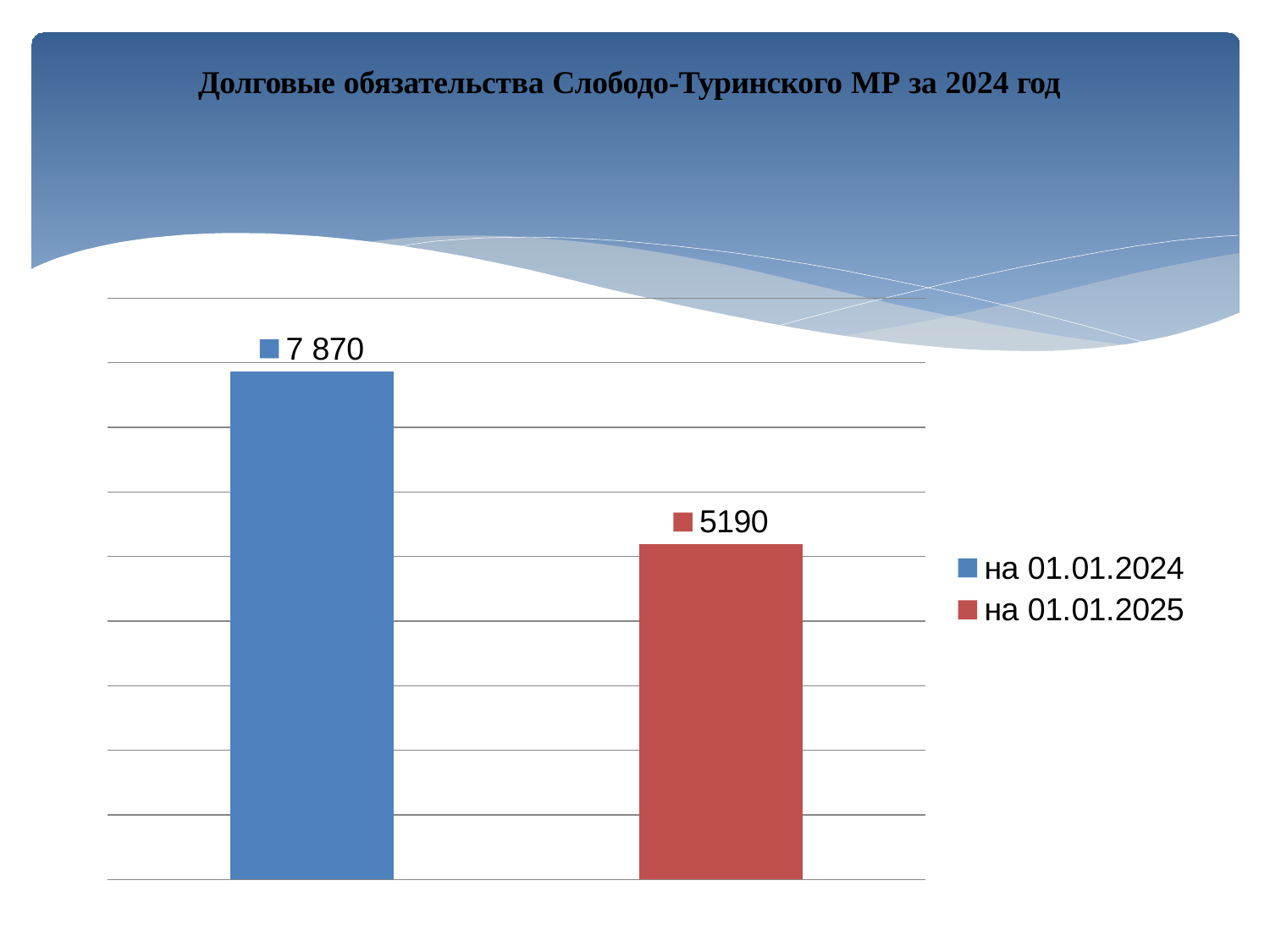
How many series does the legend list? 2 Do the values rise or fall from на 01.01.2024 to на 01.01.2025? fall Which series has the lowest value? на 01.01.2025 Which is larger: the value for на 01.01.2024 or the value for на 01.01.2025? на 01.01.2024 What is the difference between the value for на 01.01.2024 and the value for на 01.01.2025? 2680 What is the value for на 01.01.2024? 7 870 How many bars are plotted on the chart? 2 What is the value for на 01.01.2025? 5190 What kind of chart is shown on the slide? bar chart Which series has the highest value? на 01.01.2024 What is the title of the chart? Долговые обязательства Слободо-Туринского МР за 2024 год What colour is the bar for на 01.01.2025? red